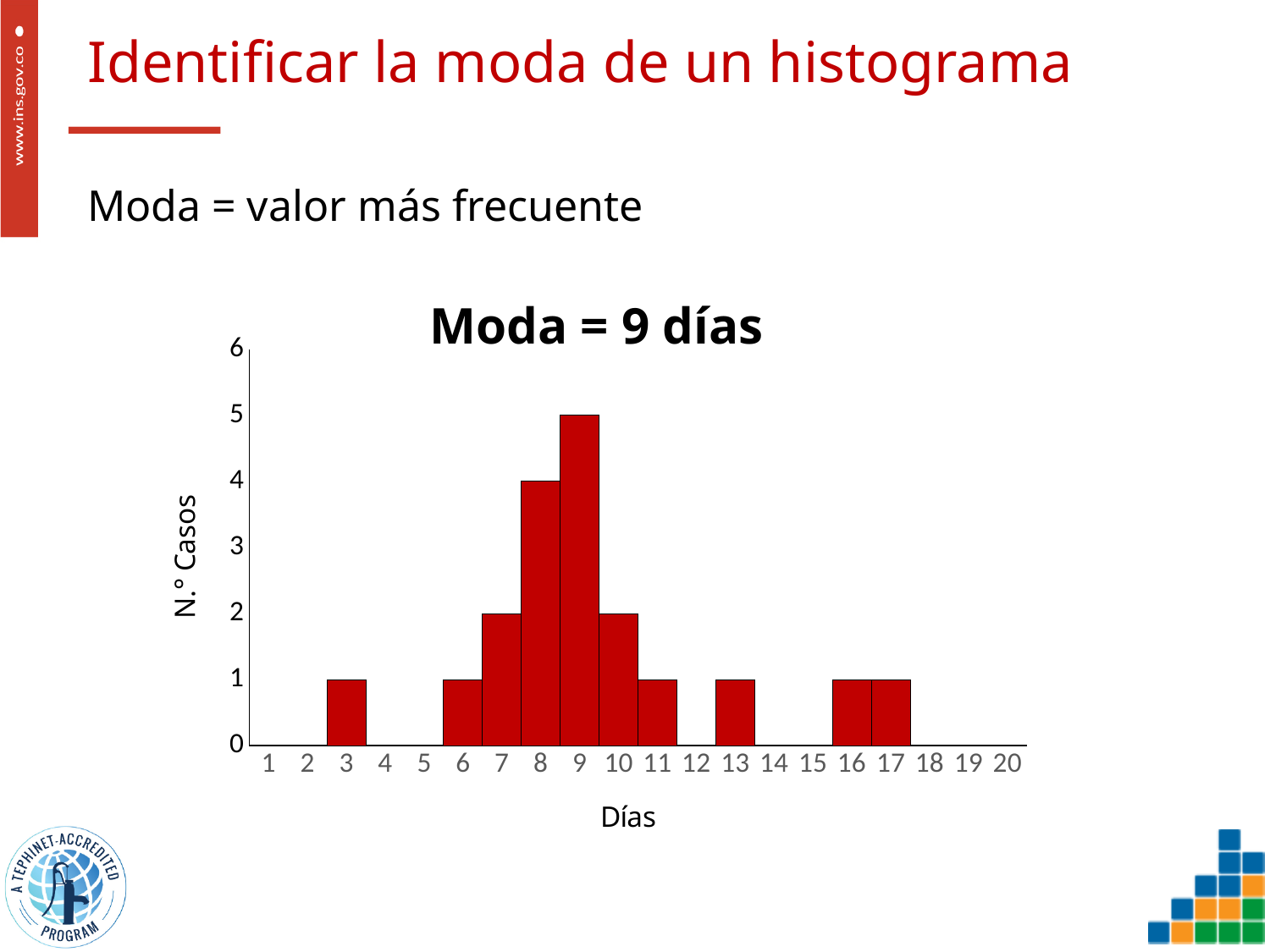
How many days are labelled on the x axis? 20 What is the number of cases (N.° Casos) for day 9? 5 What is the label of the y axis? N.° Casos What is the number of cases for day 7? 2 What type of chart is shown on the slide? bar chart What is the difference in cases between day 9 and day 8? 1 What is the title of the chart? Moda = 9 días How many days have at least one case (non-zero bars)? 10 What is the number of cases for day 3? 1 What is the number of cases for day 8? 4 Which has more cases, day 10 or day 11? day 10 Which day has the highest number of cases? 9